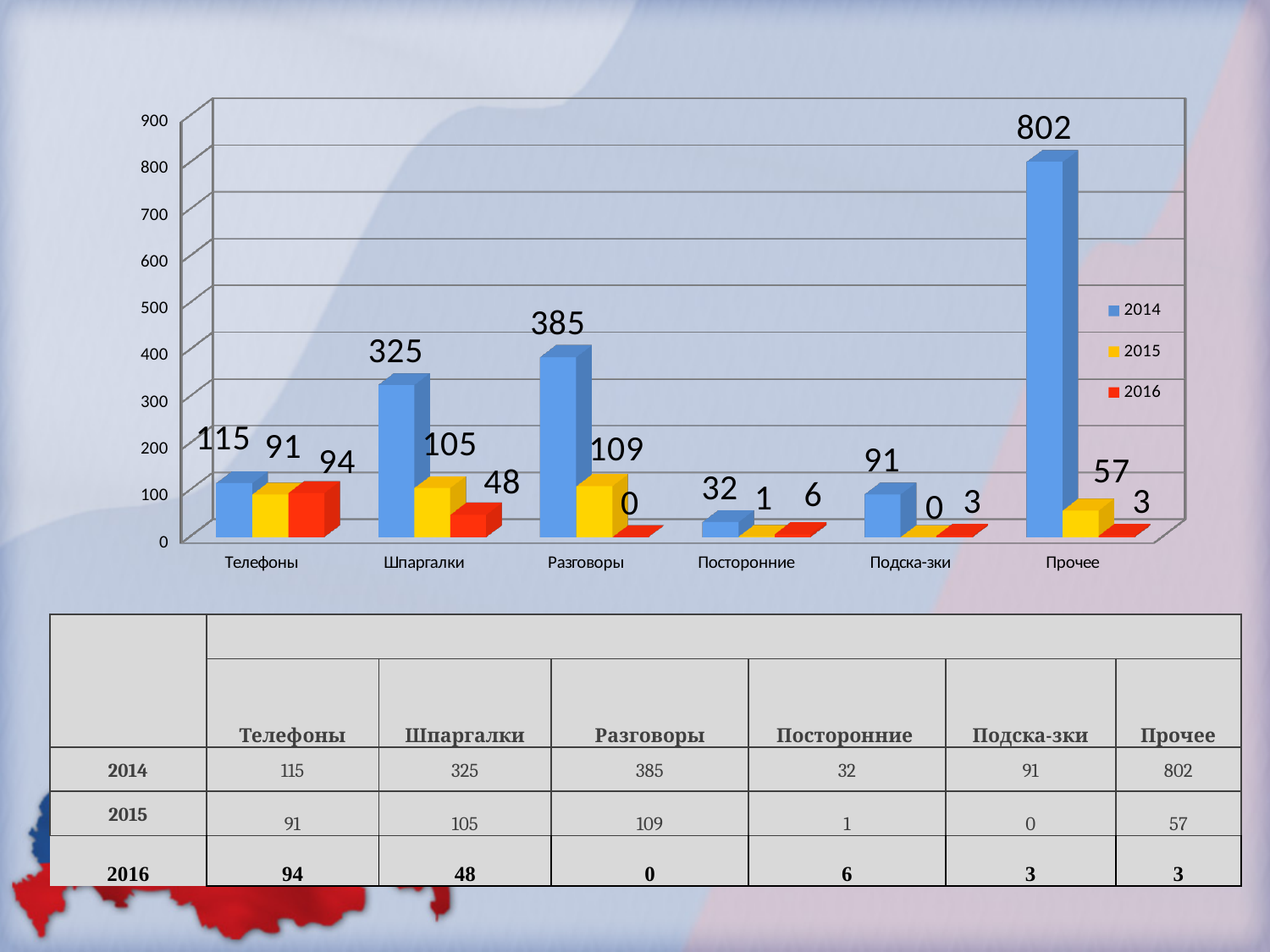
What is the value for Разговоры in the 2015 series? 109 What is the difference between the 2014 and 2015 values for Прочее? 745 Which colour represents the 2016 series in the legend? red Which category has the lowest value in the 2014 series? Посторонние Which category has the highest value in the 2014 series? Прочее Which is larger: the 2015 value for Шпаргалки or the 2015 value for Разговоры? Разговоры What kind of chart is shown on the slide? bar chart What is the value for Телефоны in the 2014 series? 115 Is the 2014 value for Разговоры greater or less than 300? greater What is the value for Шпаргалки in the 2016 series? 48 How many categories are shown on the x axis? 6 How many series does the legend list? 3